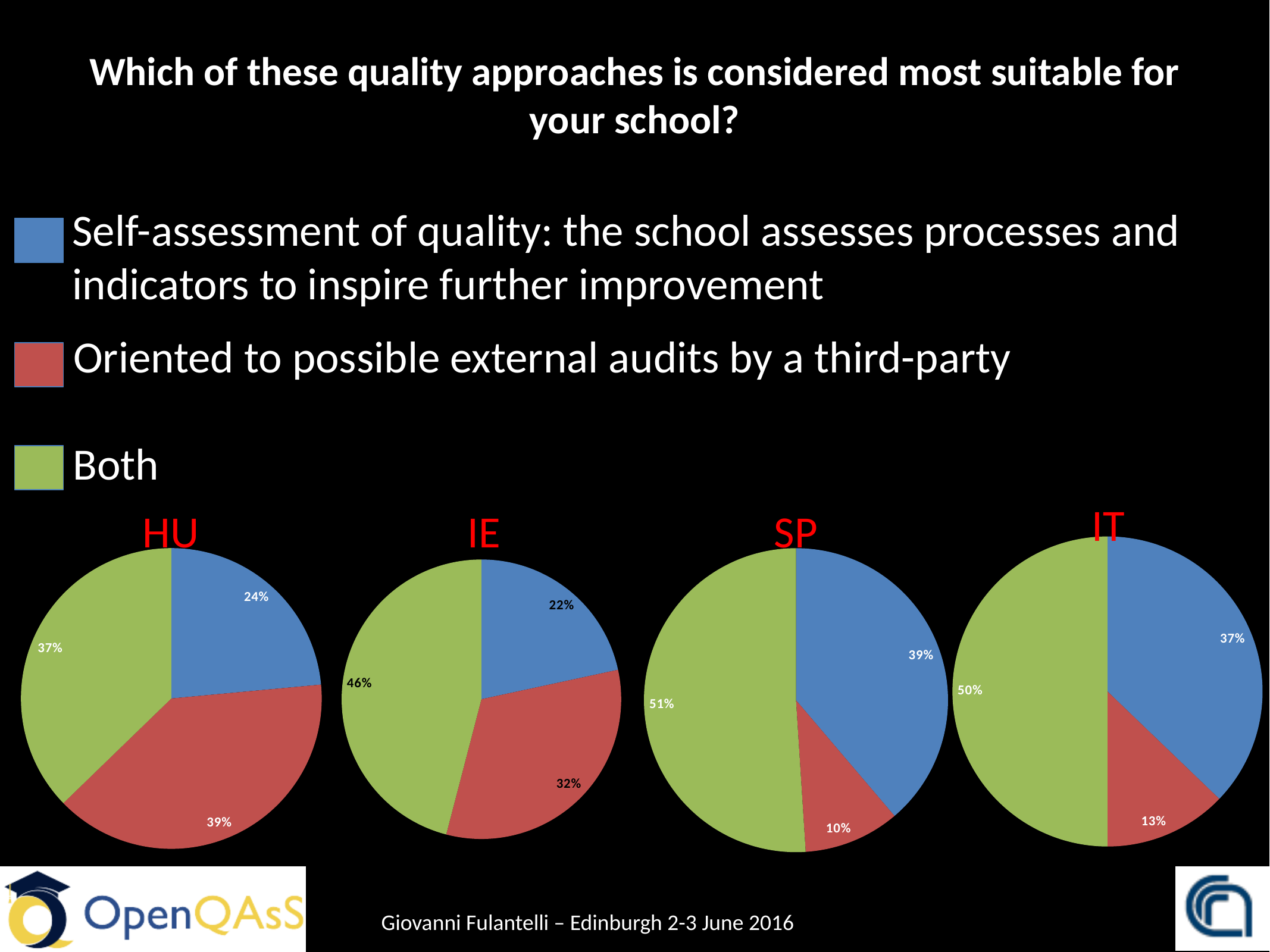
In the IT pie chart, what is the difference between the 'Self-assessment of quality' share and the 'Oriented to possible external audits by a third-party' share? 24% In the HU pie chart, which is larger: the share for 'Oriented to possible external audits by a third-party' or the share for 'Self-assessment of quality'? Oriented to possible external audits by a third-party In the SP pie chart, what share is labelled for 'Self-assessment of quality'? 39% In the IE pie chart, which option has the largest share? Both In the SP pie chart, which option has the smallest share? Oriented to possible external audits by a third-party How many pie charts are on the slide? 4 In the IE pie chart, what share is labelled for 'Oriented to possible external audits by a third-party'? 32% Which colour represents 'Both' in the pie charts? Green In the IT pie chart, what share is labelled for 'Both'? 50% What kind of charts are shown on the slide? Pie charts In the HU pie chart, what share is labelled for 'Both'? 37% In the HU pie chart, what share is labelled for 'Self-assessment of quality'? 24%